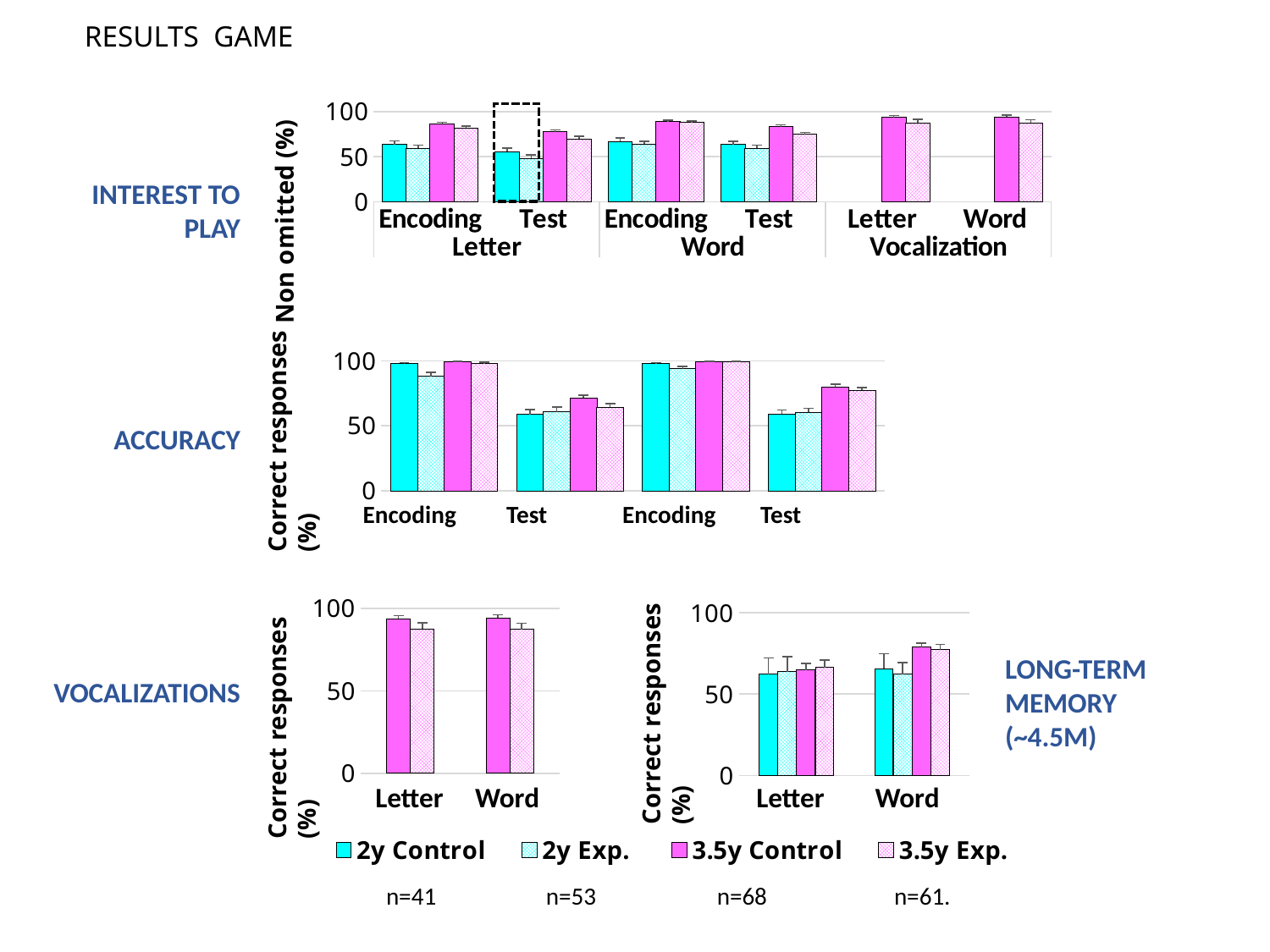
What kind of chart is the Interest to Play chart at the top of the slide? bar chart How many series does the legend at the bottom of the slide list? 4 In the Interest to Play chart, at Letter Test, which is larger: 3.5y Control or 2y Control? 3.5y Control How many categories are shown on the x axis of the Vocalizations chart at the bottom left? 2 In the Accuracy chart, is the value for 2y Control at the first Test category greater or less than 100? less In the Long-term Memory chart at the bottom right, is the value for 2y Control at Letter greater or less than 100? less In the Interest to Play chart, is the value for 3.5y Control at Word Encoding greater or less than 50? greater What is the y-axis label of the Interest to Play chart? Non omitted (%) In the Long-term Memory chart at the bottom right, at Word, which is larger: 3.5y Control or 2y Exp.? 3.5y Control In the Accuracy chart, at the second Test category, which is larger: 3.5y Control or 2y Control? 3.5y Control How many category labels are shown on the x axis of the Accuracy chart? 4